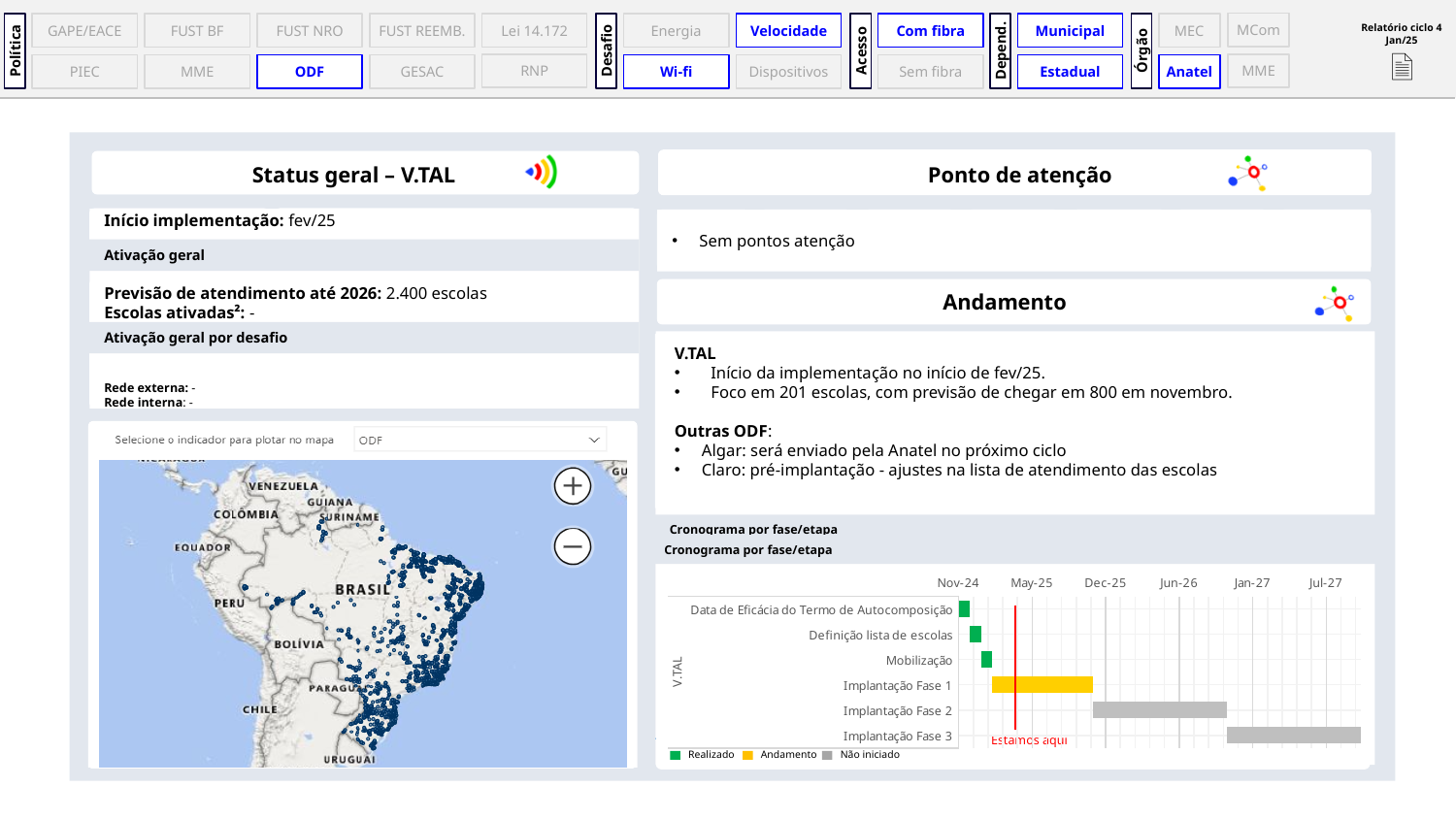
In the 'Cronograma por fase/etapa' chart, which task is listed first (top row)? Data de Eficácia do Termo de Autocomposição In the 'Cronograma por fase/etapa' chart, what is the last date label on the time axis? Jul-27 In the 'Cronograma por fase/etapa' chart, which task's bar extends furthest to the right, Implantação Fase 2 or Implantação Fase 3? Implantação Fase 3 In the 'Cronograma por fase/etapa' chart, what status is shown for 'Mobilização'? Realizado In the 'Cronograma por fase/etapa' chart, what text labels the red vertical line? Estamos aqui How many entries does the legend of the 'Cronograma por fase/etapa' chart list? 3 In the 'Cronograma por fase/etapa' chart, what is the first date label on the time axis? Nov-24 In the 'Cronograma por fase/etapa' chart, which task is shown with the 'Andamento' (yellow) status? Implantação Fase 1 What is the title of the chart at the bottom right of the slide? Cronograma por fase/etapa In the 'Cronograma por fase/etapa' chart, which tasks are shown as 'Não iniciado'? Implantação Fase 2 and Implantação Fase 3 What kind of chart is the 'Cronograma por fase/etapa' chart? Gantt chart How many tasks (rows) are listed in the 'Cronograma por fase/etapa' chart? 6